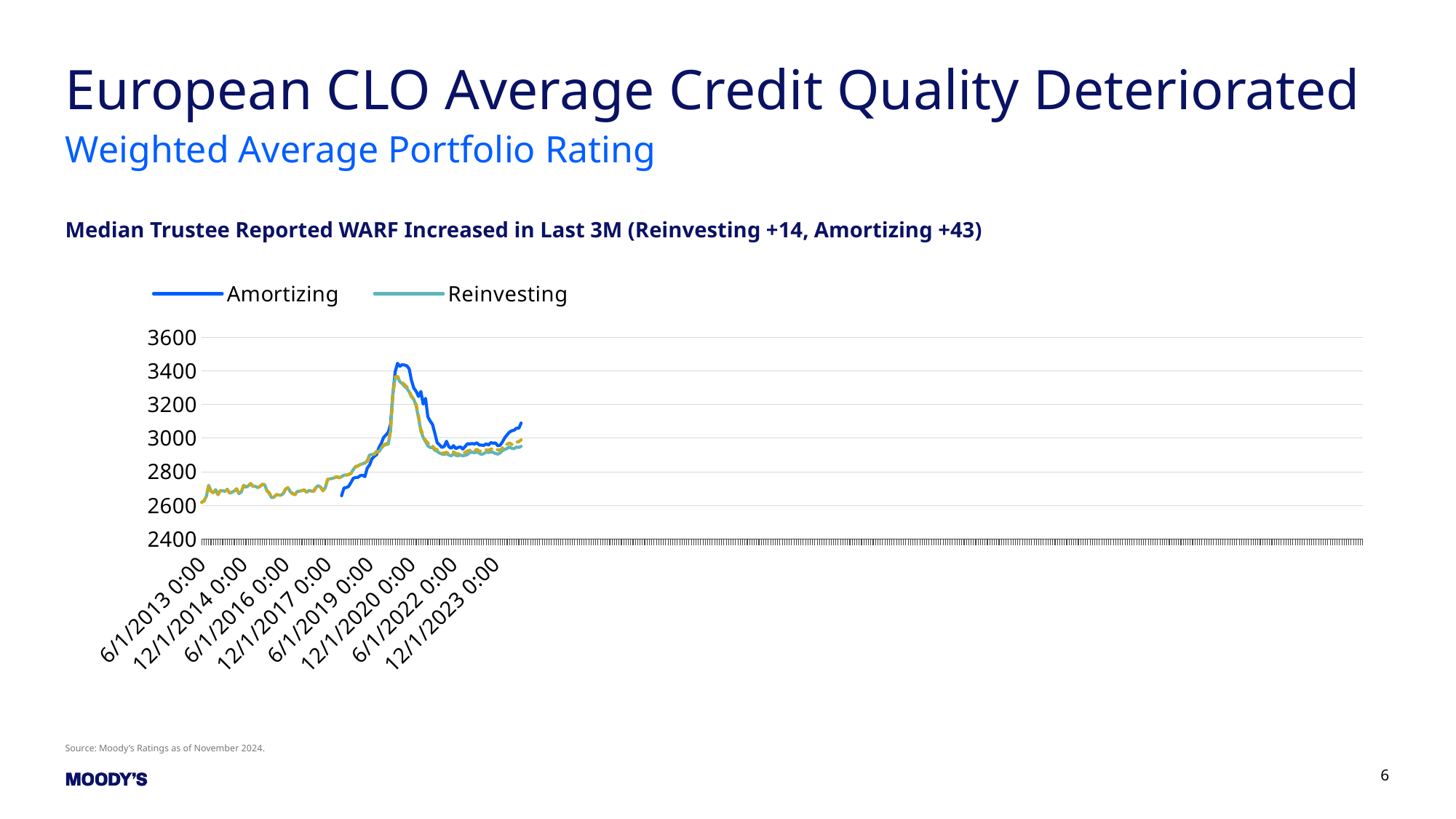
How many series does the legend list? 2 Is the peak value of the Reinvesting series greater or less than 3200? greater Which series reaches the higher peak, Amortizing or Reinvesting? Amortizing What is the chart's heading above the legend? Median Trustee Reported WARF Increased in Last 3M (Reinvesting +14, Amortizing +43) Is the peak value of the Amortizing series greater or less than 3200? greater What are the two series named in the legend? Amortizing and Reinvesting How many date labels are shown on the x axis? 8 At the right-hand end of the plotted lines, which series is higher, Amortizing or Reinvesting? Amortizing Between 6/1/2019 0:00 and the peak near 12/1/2020 0:00, do the series rise or fall? rise What is the highest value shown on the y axis? 3600 Is the value of the Reinvesting series at 6/1/2013 0:00 greater or less than 2800? less What kind of chart is shown on the slide? line chart